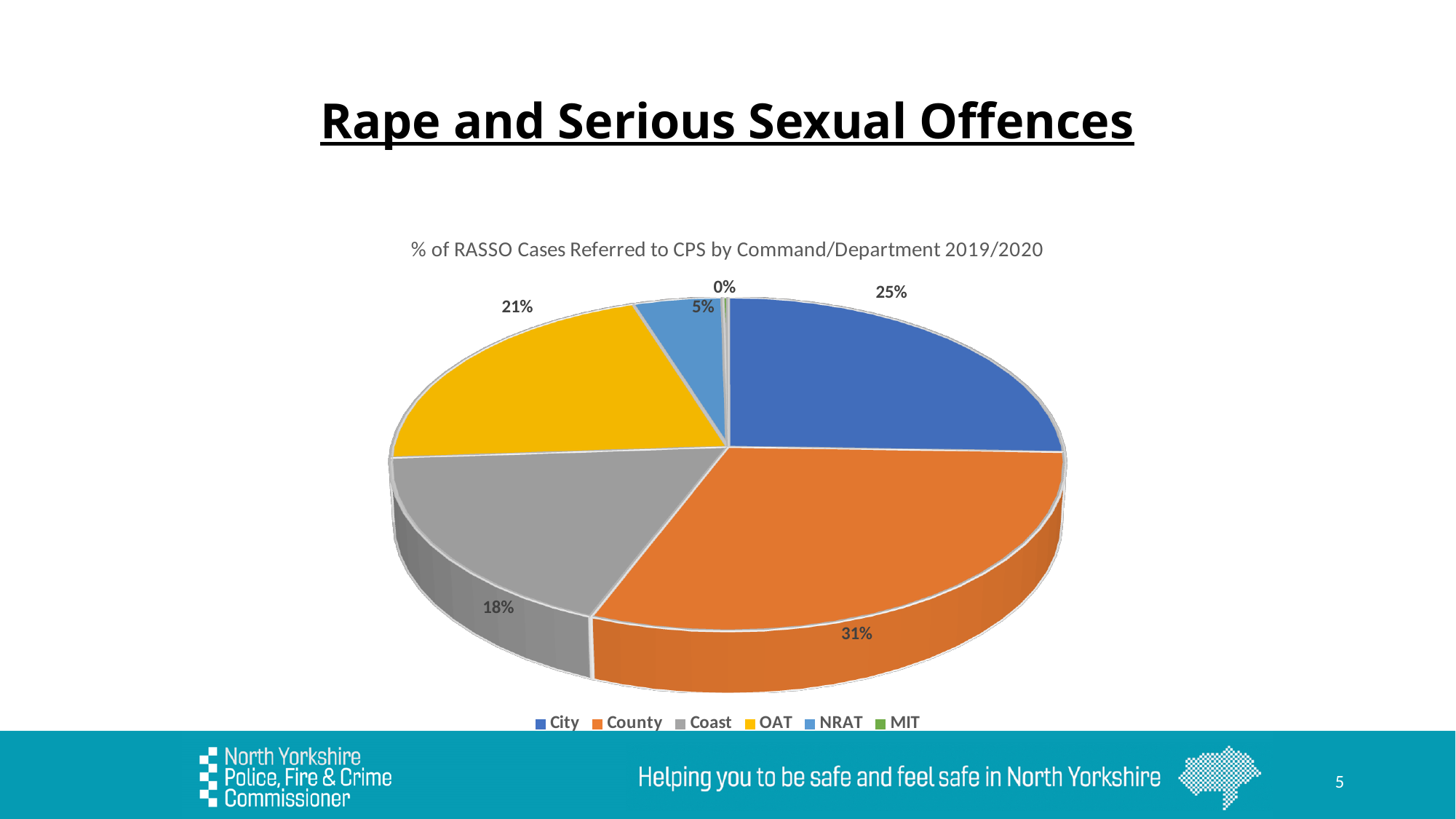
What percentage of RASSO cases referred to CPS came from City? 25% Which has a larger share, OAT or Coast? OAT What share of the pie does OAT account for? 21% What is the difference in percentage points between County and City? 6 What percentage is shown for MIT? 0% What percentage of RASSO cases referred to CPS came from County? 31% What percentage is shown for Coast? 18% Which command/department has the smallest share of RASSO cases referred to CPS? MIT What type of chart is shown on the slide? Pie chart How many categories does the legend list? 6 What percentage is shown for NRAT? 5% Which command/department has the largest share of RASSO cases referred to CPS? County